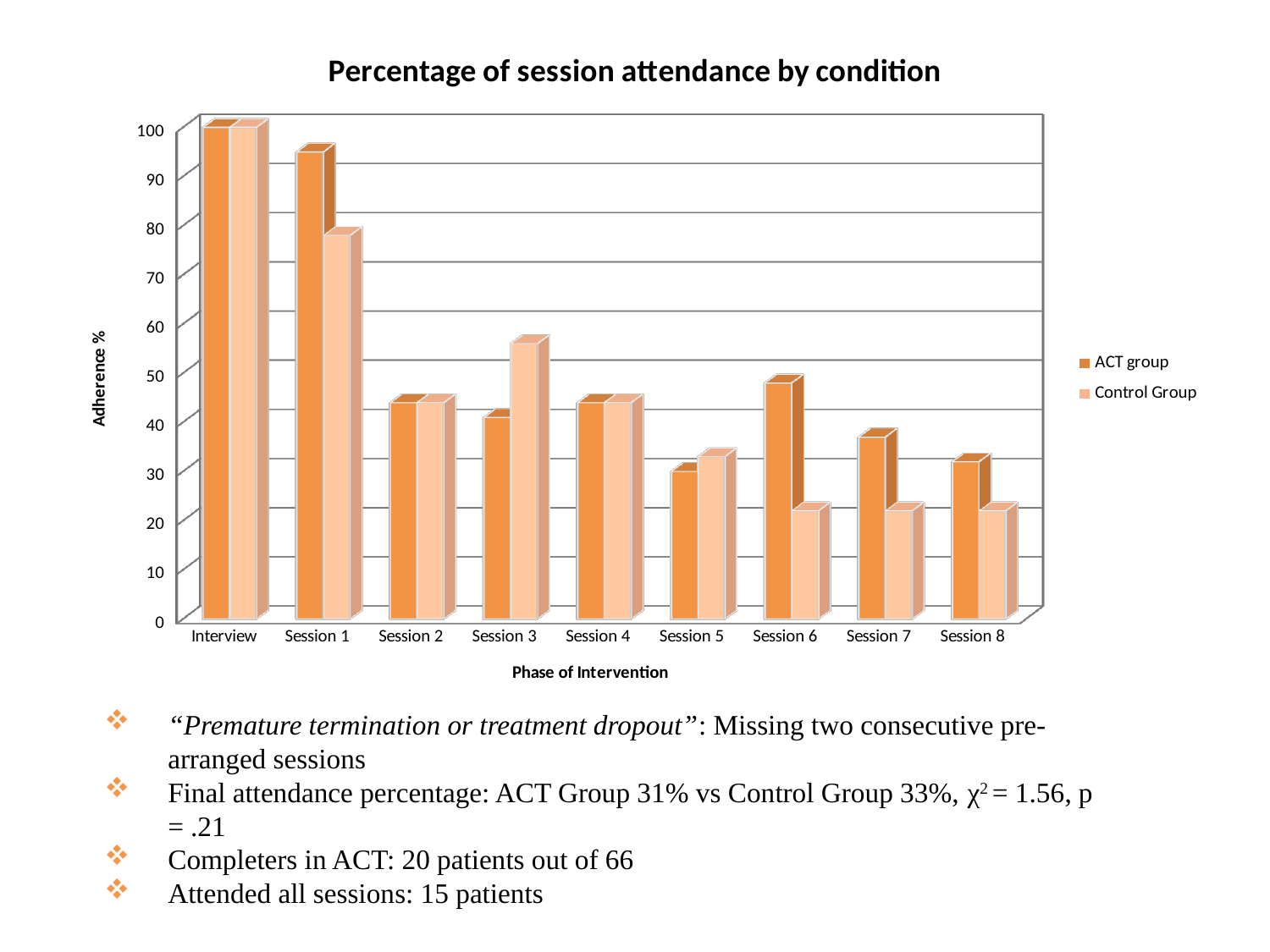
At Session 3, which group has the higher adherence, ACT group or Control Group? Control Group Is the ACT group value for Session 6 greater or less than 40? greater How many phases of intervention are shown on the x axis? 9 What is the title of the chart? Percentage of session attendance by condition Which phase has the highest adherence for the ACT group? Interview Is the Control Group value for Session 8 greater or less than 30? less Is the Control Group value for Session 1 greater or less than 70? greater What is the label of the vertical axis? Adherence % What kind of chart is shown on the slide? Bar chart At Session 1, which group has the higher adherence, ACT group or Control Group? ACT group How many series does the legend list? 2 Which phase has the lowest adherence for the ACT group? Session 5